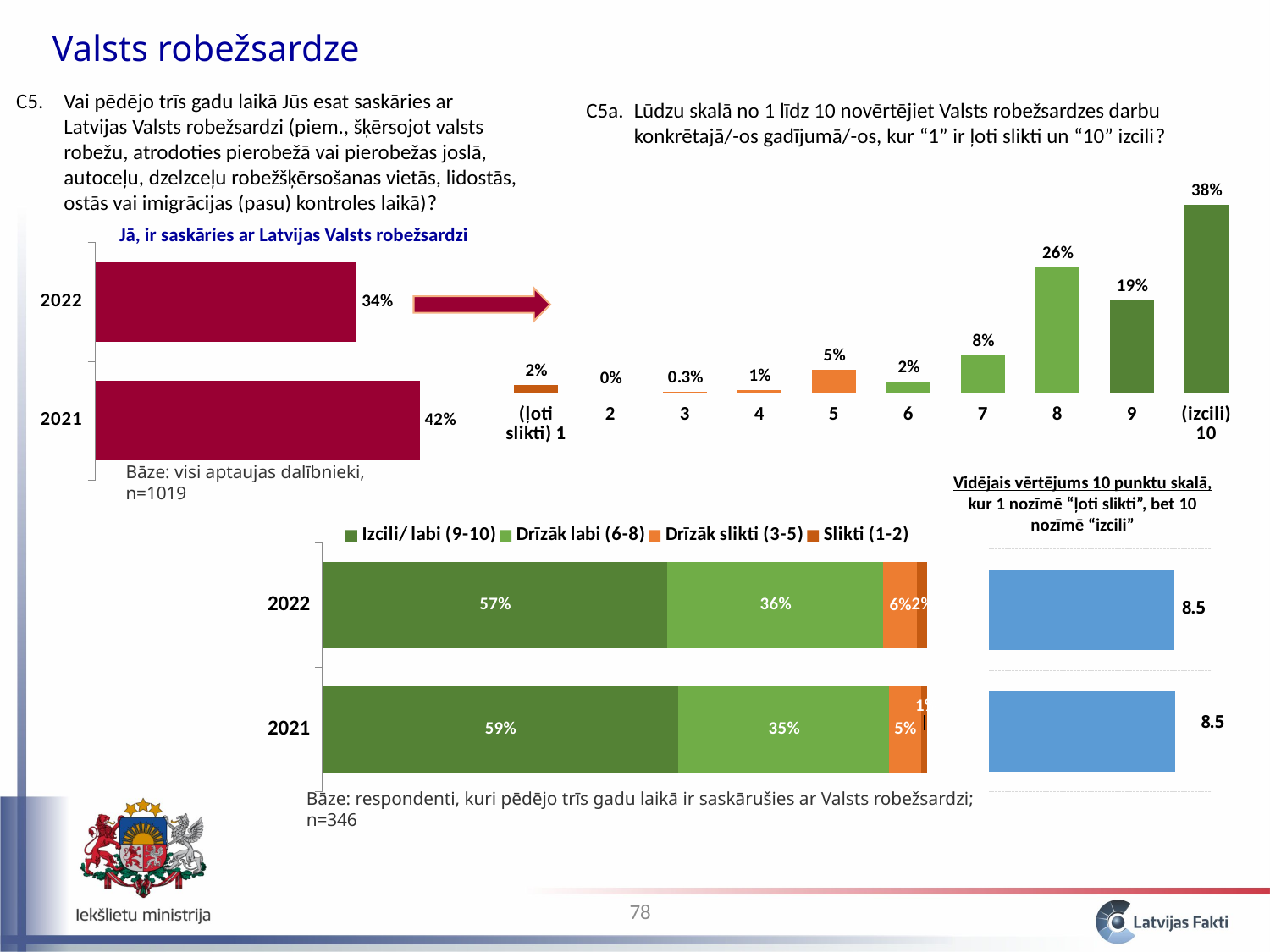
In the top-right chart (C5a, scale 1 to 10), how many rating categories are shown on the x axis? 10 How many series does the legend of the bottom stacked bar chart list? 4 In the top-left chart titled 'Jā, ir saskāries ar Latvijas Valsts robežsardzi', what is the value for 2021? 42% In the top-right chart (C5a, scale 1 to 10), what is the value for rating 8? 26% In the top-right chart (C5a, scale 1 to 10), what is the value for rating 3? 0.3% In the bottom stacked bar chart, what is the 'Drīzāk labi (6-8)' share for 2022? 36% In the bottom-right chart 'Vidējais vērtējums 10 punktu skalā', what is the average rating for 2022? 8.5 In the top-right chart (C5a, scale 1 to 10), which is larger, the value for rating 9 or rating 7? Rating 9 In the top-left chart titled 'Jā, ir saskāries ar Latvijas Valsts robežsardzi', what is the difference between the 2021 and 2022 values? 8 percentage points In the top-right chart (C5a, scale 1 to 10), which rating has the highest share? (izcili) 10 In the bottom stacked bar chart, what is the 'Izcili/ labi (9-10)' share for 2021? 59% In the top-left chart titled 'Jā, ir saskāries ar Latvijas Valsts robežsardzi', what is the value for 2022? 34%